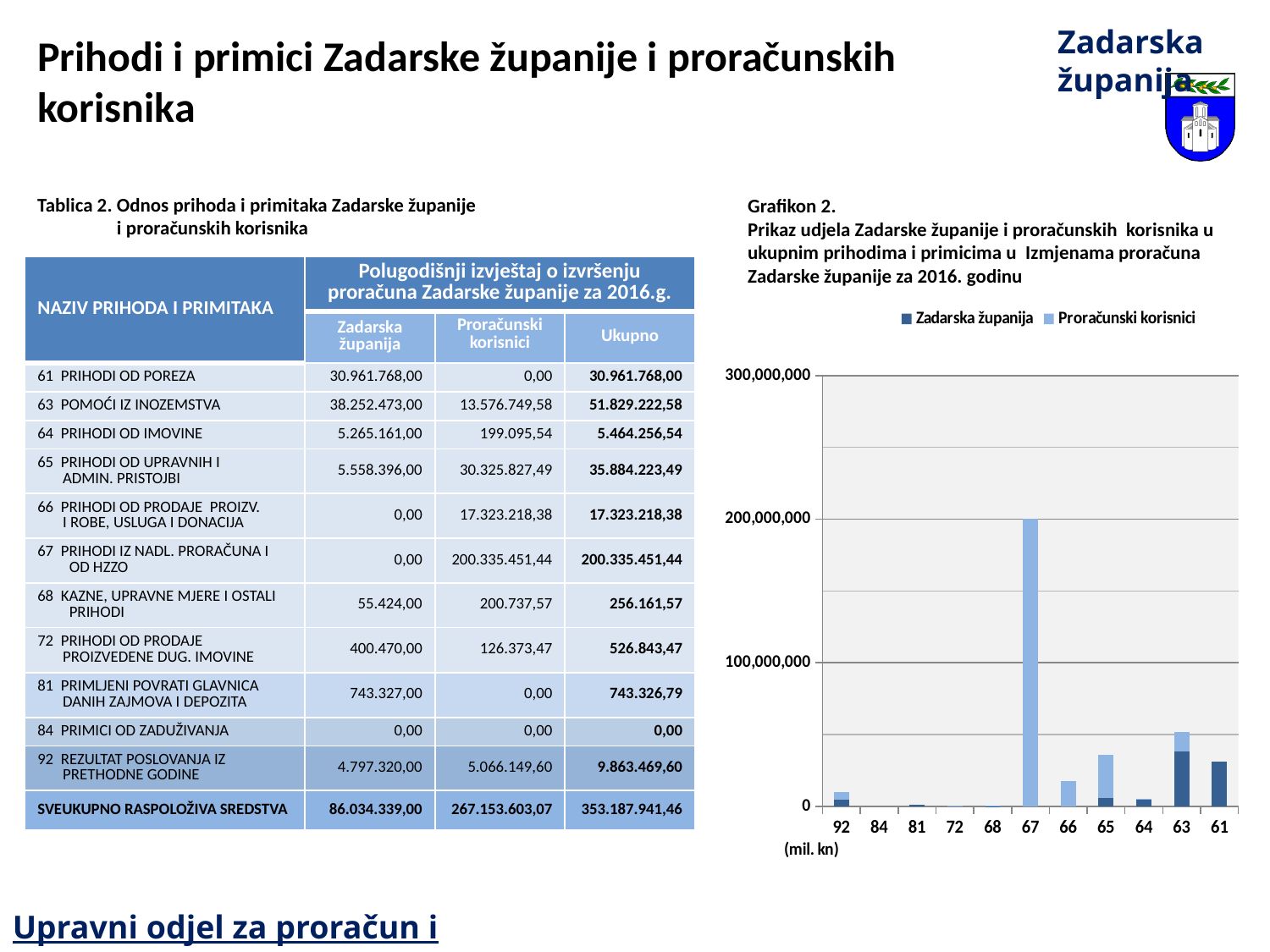
Which category has the lowest total in the chart? 84 What kind of chart is shown on the slide? bar chart Which category has the tallest bar in the chart? 67 Is the total value for category 67 greater or less than 300,000,000? less Is the total value for category 63 greater or less than 100,000,000? less How many categories are shown along the x axis of the chart? 11 Which category has a larger total bar, 63 or 61? 63 Which category has a larger total bar, 65 or 66? 65 What unit is indicated below the x axis of the chart? (mil. kn) How many series does the chart legend list? 2 Is the total value for category 67 greater or less than 100,000,000? greater What are the two series named in the chart legend? Zadarska županija and Proračunski korisnici